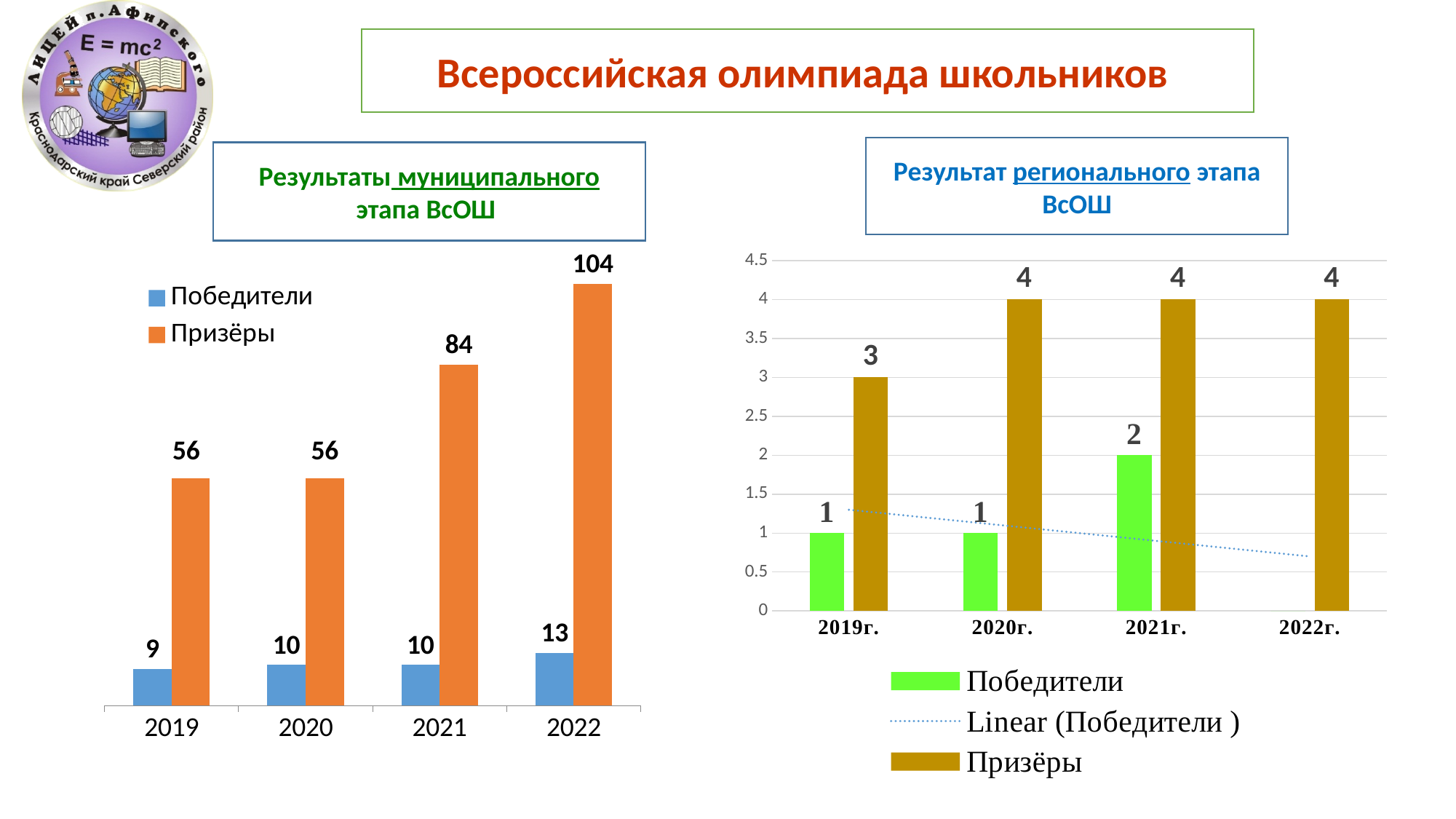
In the right chart (Результат регионального этапа ВсОШ), what is the value for Призёры in 2019г.? 3 In the left chart (Результаты муниципального этапа ВсОШ), how many years are shown on the x axis? 4 In the right chart (Результат регионального этапа ВсОШ), what is the value for Победители in 2021г.? 2 In the left chart (Результаты муниципального этапа ВсОШ), what is the value for Призёры in 2022? 104 In the left chart (Результаты муниципального этапа ВсОШ), what is the difference between Призёры in 2022 and Призёры in 2021? 20 In the right chart (Результат регионального этапа ВсОШ), which is larger in 2020г.: Победители or Призёры? Призёры In the right chart (Результат регионального этапа ВсОШ), which year has the lowest value for Призёры? 2019г. In the right chart (Результат регионального этапа ВсОШ), how many entries does the legend list? 3 In the left chart (Результаты муниципального этапа ВсОШ), which year has the highest value for Призёры? 2022 In the left chart (Результаты муниципального этапа ВсОШ), do the Призёры values rise or fall from 2020 to 2022? rise In the left chart (Результаты муниципального этапа ВсОШ), what is the value for Победители in 2019? 9 What type of chart is the left chart (Результаты муниципального этапа ВсОШ)? bar chart